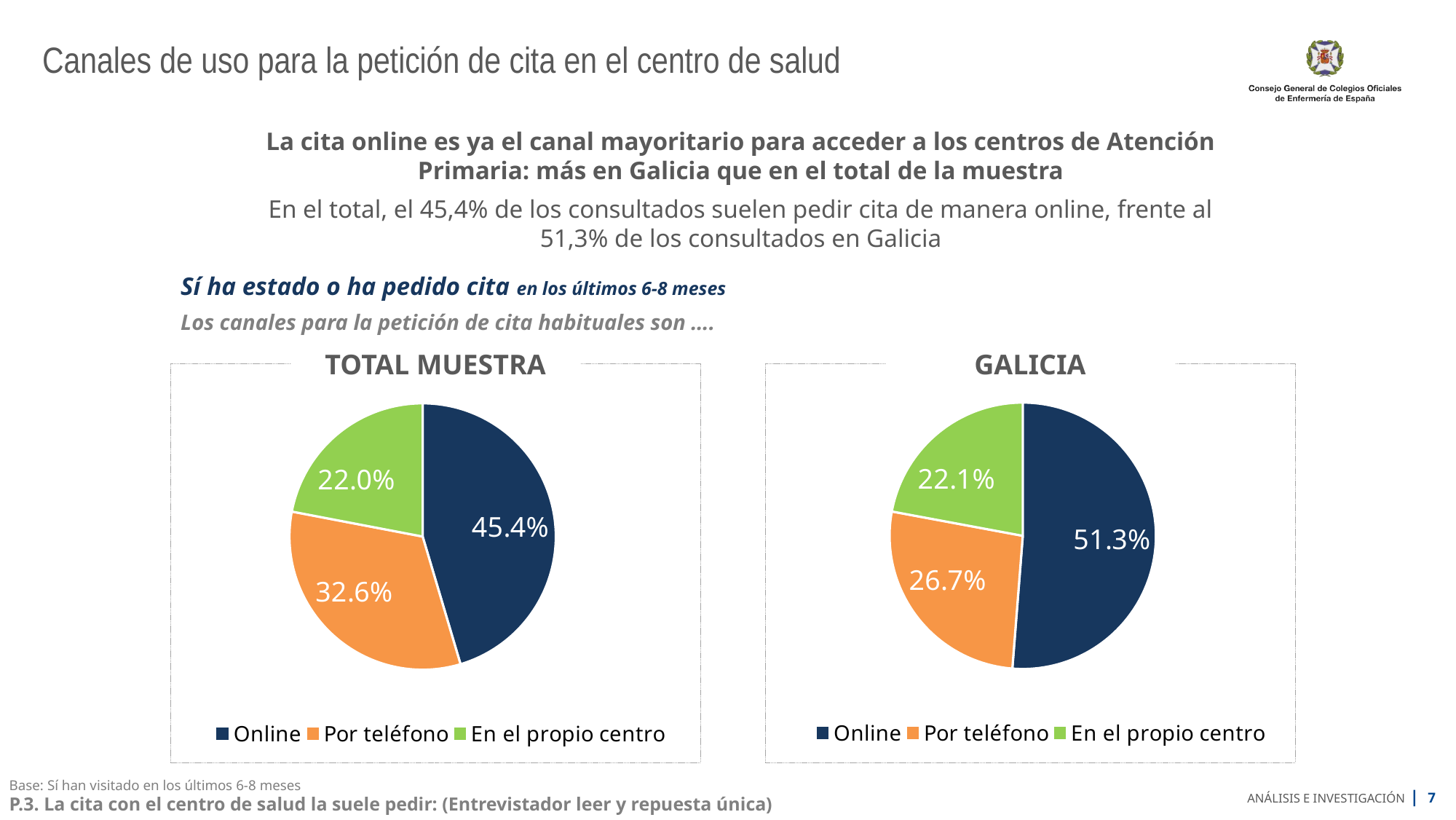
What is the difference between the Online share in the GALICIA chart and the Online share in the TOTAL MUESTRA chart? 5.9% In the TOTAL MUESTRA chart, what is the value for En el propio centro? 22.0% In the GALICIA chart, what is the value for Por teléfono? 26.7% In the TOTAL MUESTRA chart, what share of respondents request appointments Online? 45.4% In the TOTAL MUESTRA chart, which category has the smallest slice? En el propio centro In the GALICIA chart, what colour is the Online slice? Dark blue How many categories does the GALICIA pie chart show? 3 Which is larger: Por teléfono in the TOTAL MUESTRA chart or Por teléfono in the GALICIA chart? TOTAL MUESTRA What type of chart is the TOTAL MUESTRA chart? Pie chart What is the title of the chart on the right side of the slide? GALICIA In the TOTAL MUESTRA chart, what is the difference between Por teléfono and En el propio centro? 10.6% In the GALICIA chart, which category has the largest slice? Online